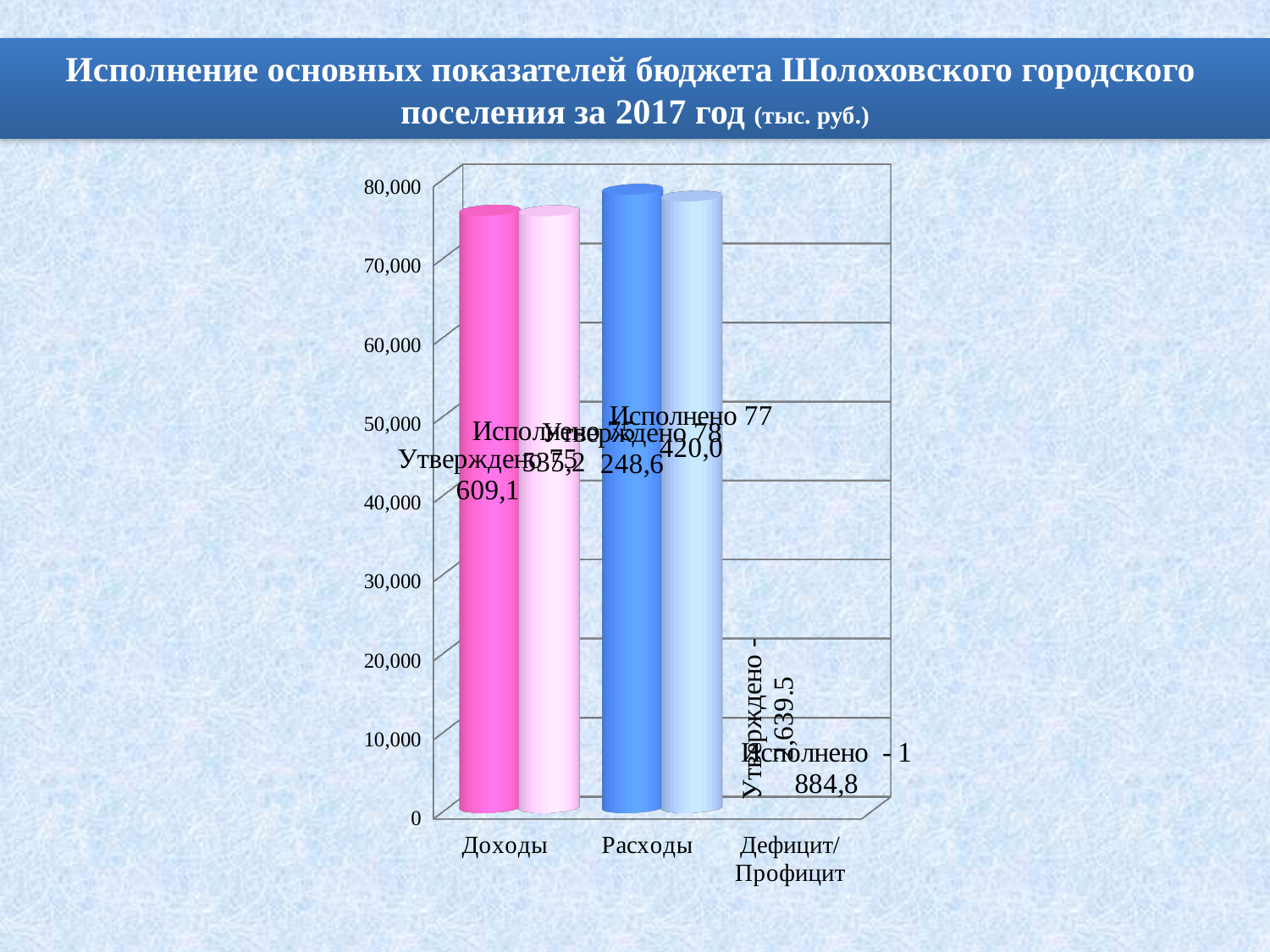
Which is larger, the approved value for Расходы or the approved value for Доходы? Расходы What year does the chart title say the budget indicators refer to? 2017 What kind of chart is shown on the slide? bar chart What is the approved (Утверждено) value for Доходы? 75 609,1 What is the difference between the approved and executed values for Расходы? 828,6 How many categories are shown on the x axis of the chart? 3 What is the approved (Утверждено) value for Расходы? 78 248,6 What is the executed (Исполнено) value for Расходы? 77 420,0 What is the executed (Исполнено) value for Дефицит/Профицит? -1 884,8 What is the approved (Утверждено) value for Дефицит/Профицит? -1,639.5 Which category has the tallest bar in the chart? Расходы Is the approved value for Доходы greater or less than 70,000? greater